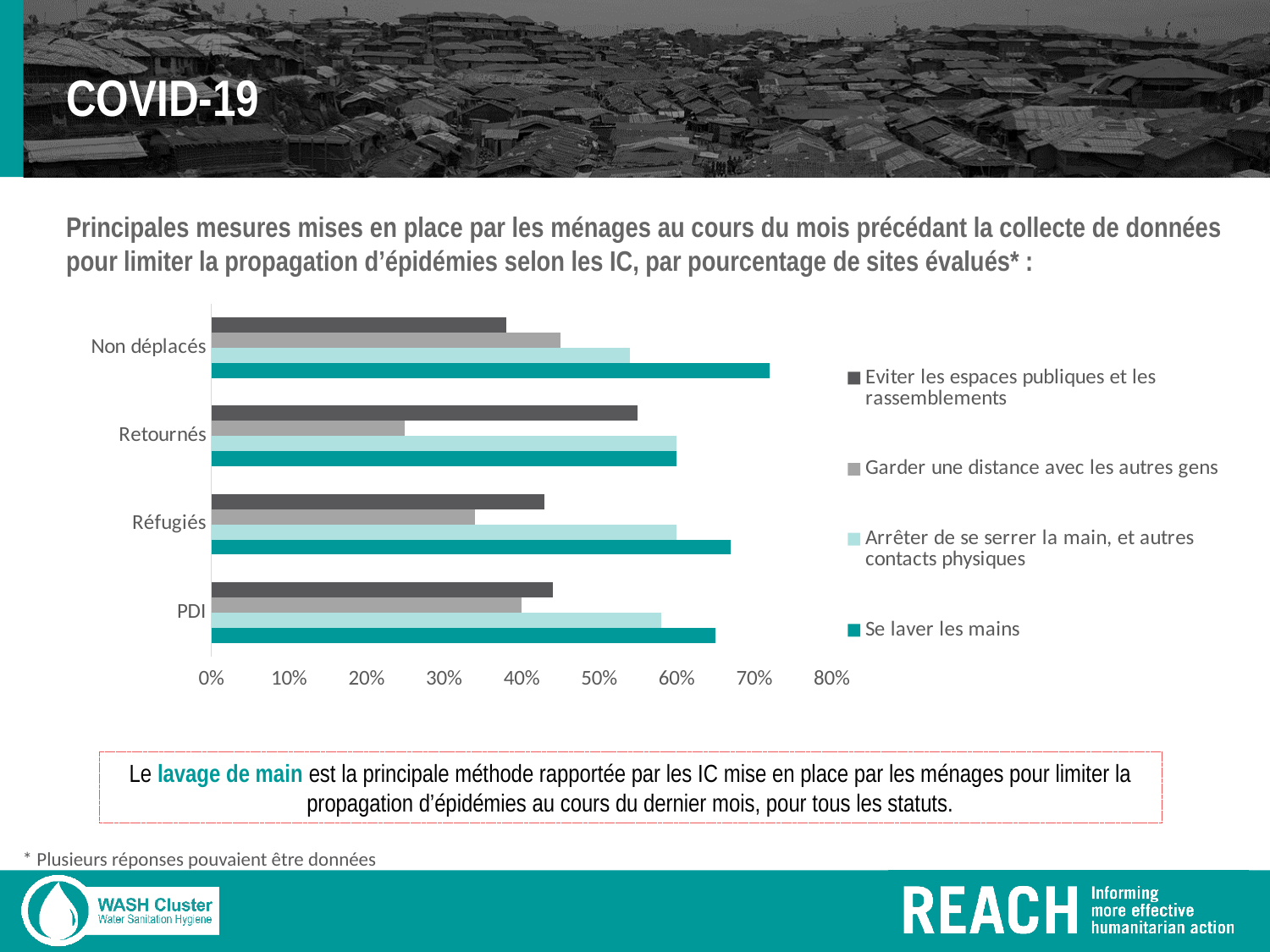
Is the value for 'Se laver les mains' among Non déplacés greater or less than 60%? greater For Non déplacés, which is larger: 'Se laver les mains' or 'Arrêter de se serrer la main, et autres contacts physiques'? Se laver les mains For Retournés, which is larger: 'Eviter les espaces publiques et les rassemblements' or 'Garder une distance avec les autres gens'? Eviter les espaces publiques et les rassemblements Which category has the highest value for 'Se laver les mains'? Non déplacés How many categories (population statuses) are shown on the y axis of the chart? 4 Which category has the lowest value for 'Garder une distance avec les autres gens'? Retournés What kind of chart is shown on the slide? Bar chart Is the value for 'Garder une distance avec les autres gens' among Retournés greater or less than 30%? less How many series does the chart legend list? 4 What is the highest value shown on the x axis of the chart? 80% Is the value for 'Se laver les mains' among PDI greater or less than 60%? greater